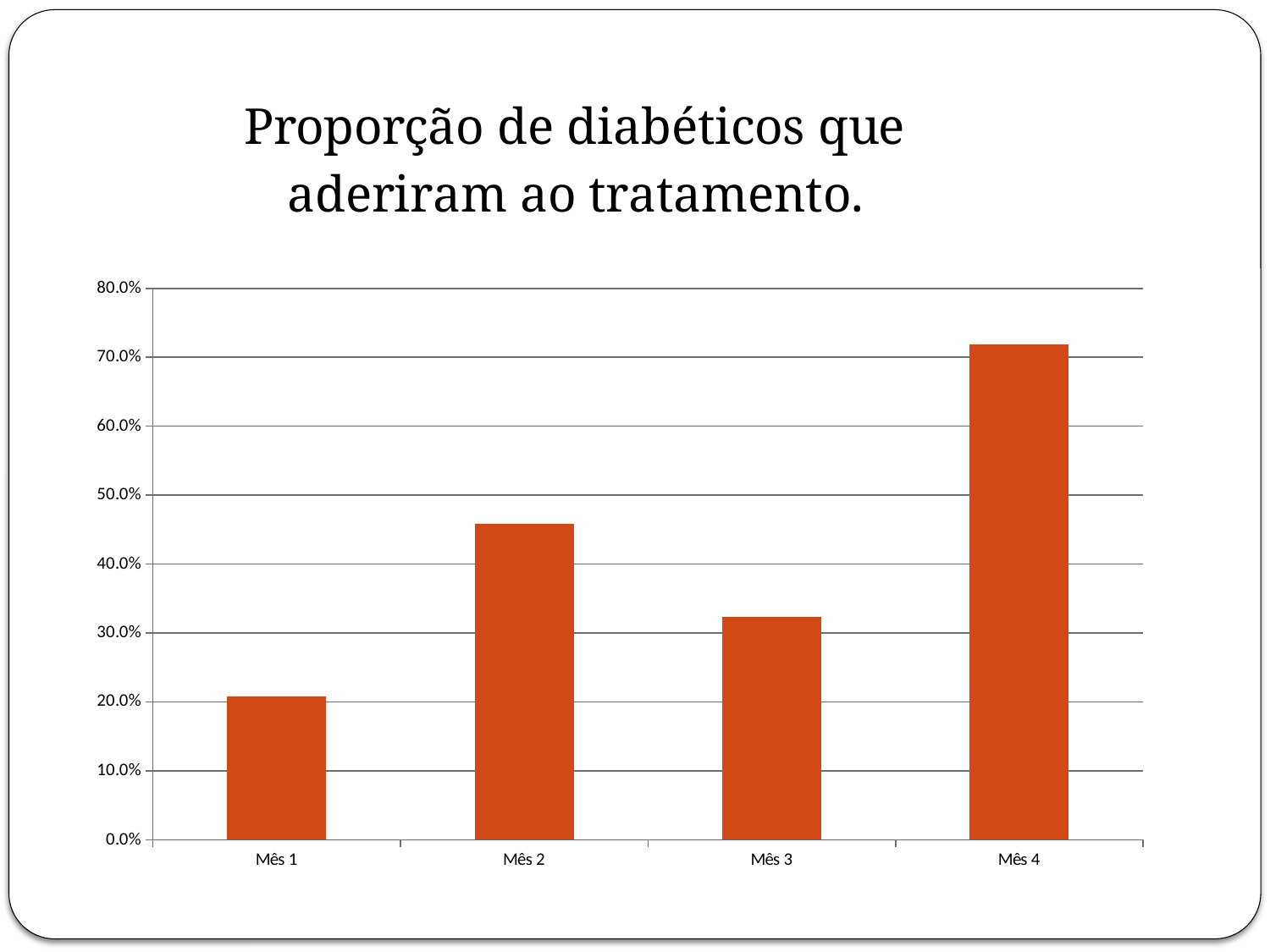
What kind of chart is shown on the slide? bar chart What is the title of the chart? Proporção de diabéticos que aderiram ao tratamento. Which month has the lowest proportion? Mês 1 Is the value for Mês 3 greater or less than 40.0%? less Is the value for Mês 1 greater or less than 30.0%? less Which month has the highest proportion? Mês 4 Is the value for Mês 4 greater or less than 60.0%? greater How many months (categories) are shown on the x axis? 4 Does the value for Mês 4 rise or fall compared with Mês 1? rise Which is larger, the value for Mês 2 or the value for Mês 3? Mês 2 Which is larger, the value for Mês 1 or the value for Mês 3? Mês 3